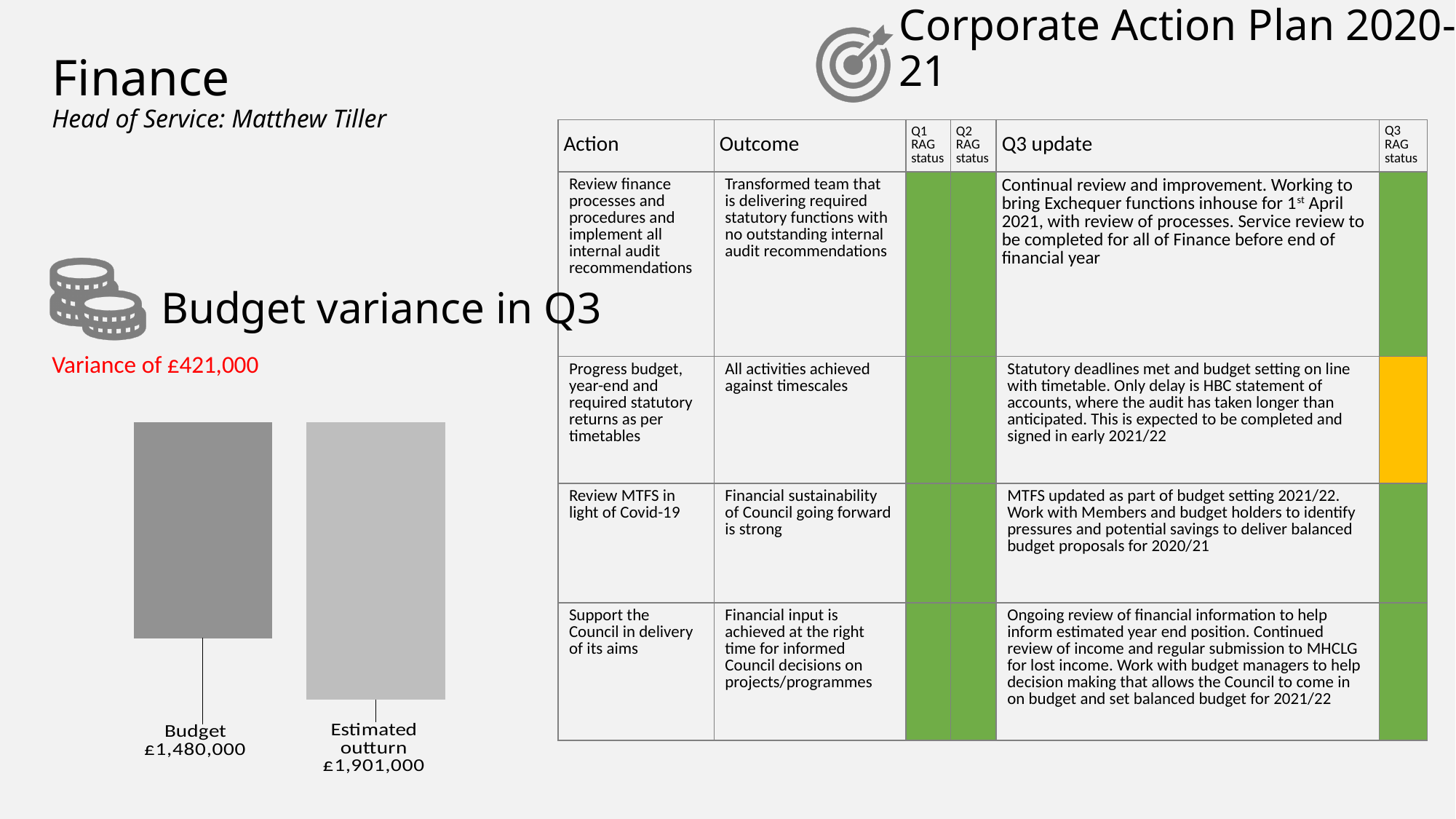
Which category has the highest value in the Budget variance in Q3 chart? Estimated outturn How many bars are shown in the Budget variance in Q3 chart? 2 Which category has the lowest value in the Budget variance in Q3 chart? Budget What is the value of the Budget bar in the Budget variance in Q3 chart? £1,480,000 What variance is stated in red text above the Budget variance in Q3 chart? Variance of £421,000 What is the difference between the Estimated outturn and the Budget in the Budget variance in Q3 chart? £421,000 What type of chart is used to show the Budget variance in Q3? Bar chart What is the value of the Estimated outturn bar in the Budget variance in Q3 chart? £1,901,000 What is the title of the chart on the left of the slide? Budget variance in Q3 Which bar is taller in the Budget variance in Q3 chart, Budget or Estimated outturn? Estimated outturn Do the values rise or fall from the Budget bar to the Estimated outturn bar in the Budget variance in Q3 chart? Rise